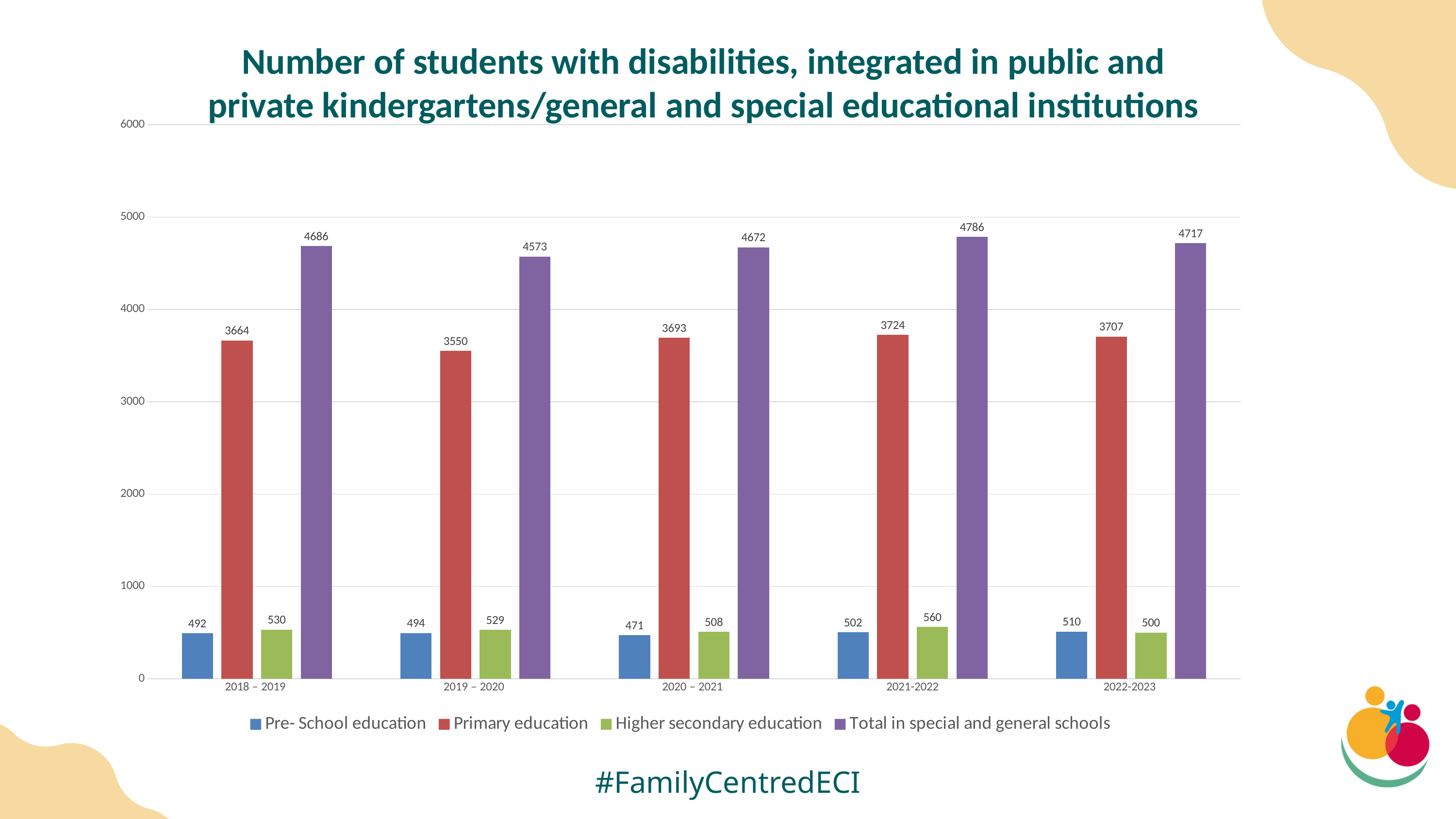
What kind of chart is shown on the slide? Bar chart What is the value for Total in special and general schools in 2021-2022? 4786 What is the value for Higher secondary education in 2022-2023? 500 How many series does the legend list? 4 Which is larger: Higher secondary education in 2021-2022 or Pre- School education in 2021-2022? Higher secondary education in 2021-2022 In which year is Primary education lowest? 2019 – 2020 What is the value for Primary education in 2018 – 2019? 3664 In which year is the Total in special and general schools highest? 2021-2022 What is the value for Pre- School education in 2020 – 2021? 471 How many year categories are shown on the x axis? 5 What is the difference between Total in special and general schools in 2021-2022 and 2022-2023? 69 Which colour represents Total in special and general schools in the legend? Purple